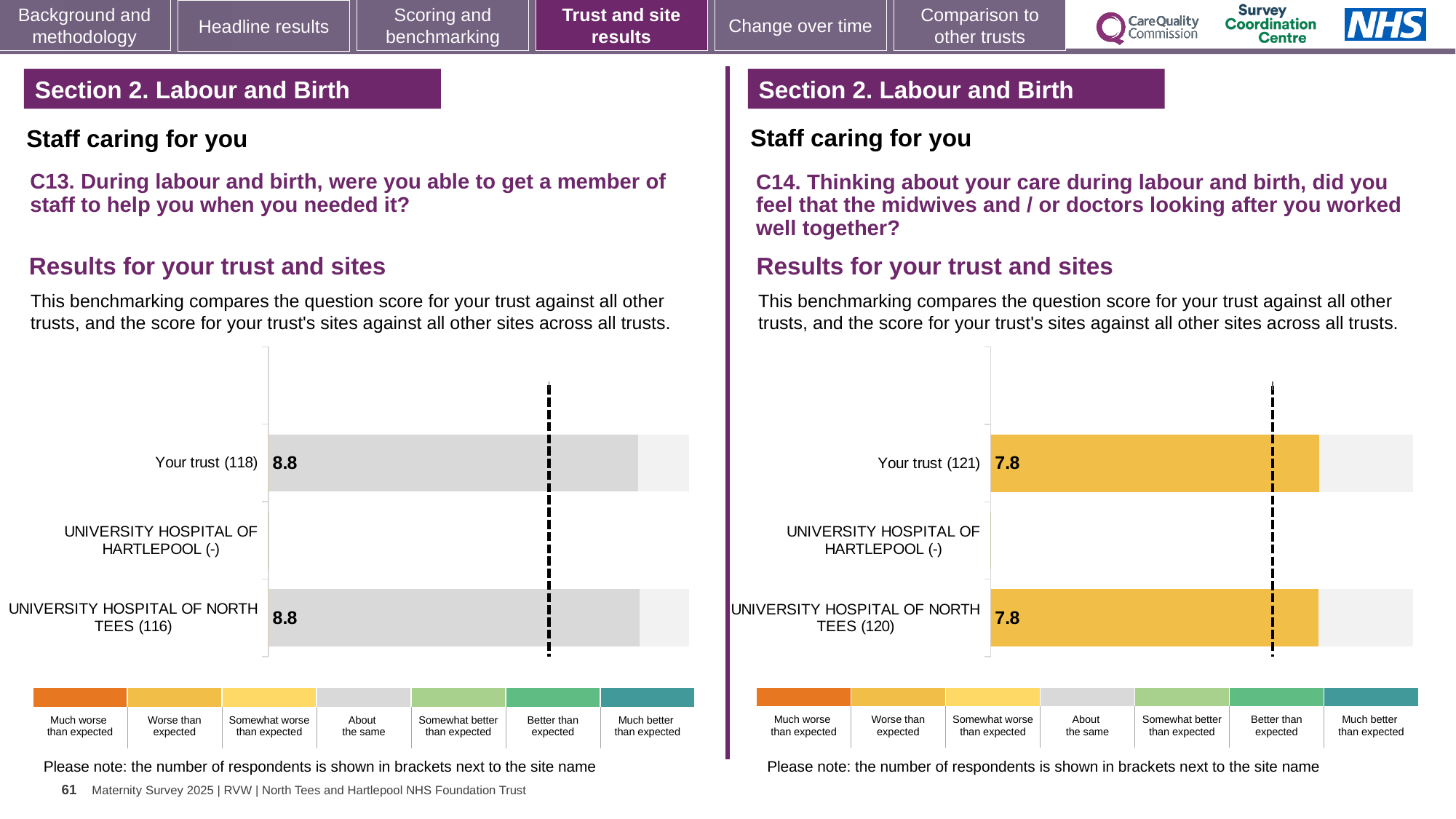
In the C13 chart on the left, what is the score for Your trust (118)? 8.8 How many categories are listed on the y axis of the C13 chart on the left? 3 In the C14 chart on the right, what is the score for Your trust (121)? 7.8 In the C14 chart on the right, what is the score for UNIVERSITY HOSPITAL OF NORTH TEES (120)? 7.8 In the C14 chart on the right, what is the difference between the score for Your trust (121) and the score for UNIVERSITY HOSPITAL OF NORTH TEES (120)? 0 In the C13 chart on the left, what is the difference between the score for Your trust (118) and the score for UNIVERSITY HOSPITAL OF NORTH TEES (116)? 0 Is the score for Your trust (118) in the C13 chart on the left larger than the score for Your trust (121) in the C14 chart on the right? Yes How many categories are listed on the y axis of the C14 chart on the right? 3 In the C14 chart on the right, which category has no bar plotted? UNIVERSITY HOSPITAL OF HARTLEPOOL (-) In the C14 chart on the right, which benchmarking band does the colour of the bars correspond to according to the legend? Worse than expected What kind of chart is the C13 chart on the left? Bar chart In the C13 chart on the left, what is the score for UNIVERSITY HOSPITAL OF NORTH TEES (116)? 8.8